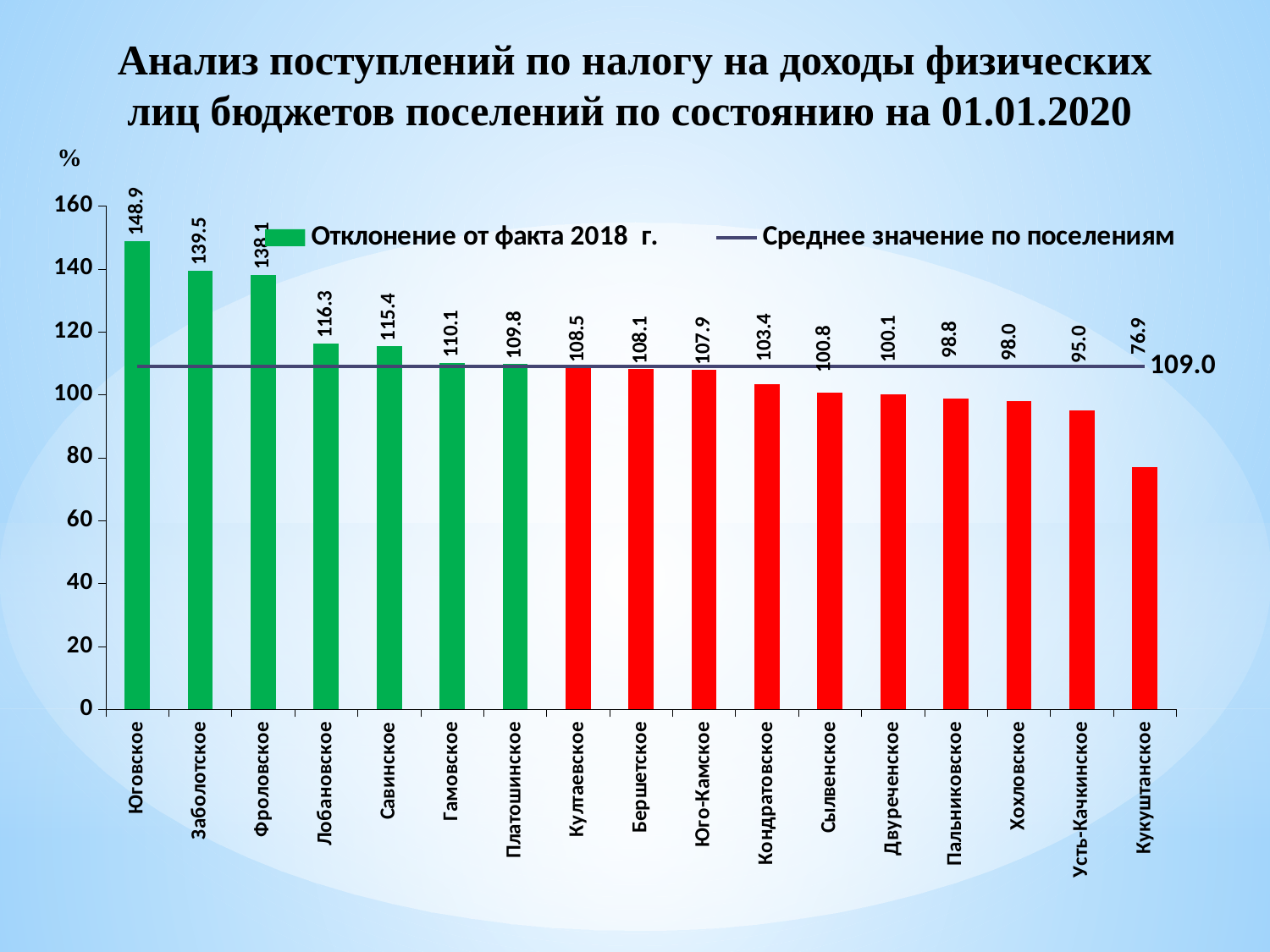
Is the value for Заболотское greater or less than 120? greater Which is larger, the value for Лобановское or the value for Хохловское? Лобановское What is the value for Кондратовское? 103.4 What is the value for Усть-Качкинское? 95.0 Which settlement has the lowest value? Кукуштанское What is the value for Юговское? 148.9 What is the difference between the values for Юговское and Кукуштанское? 72.0 What kind of chart is shown on the slide? bar chart What is the average value shown by the horizontal line (Среднее значение по поселениям)? 109.0 How many settlements are shown on the x axis? 17 Which settlement has the highest value? Юговское How many entries does the legend list? 2